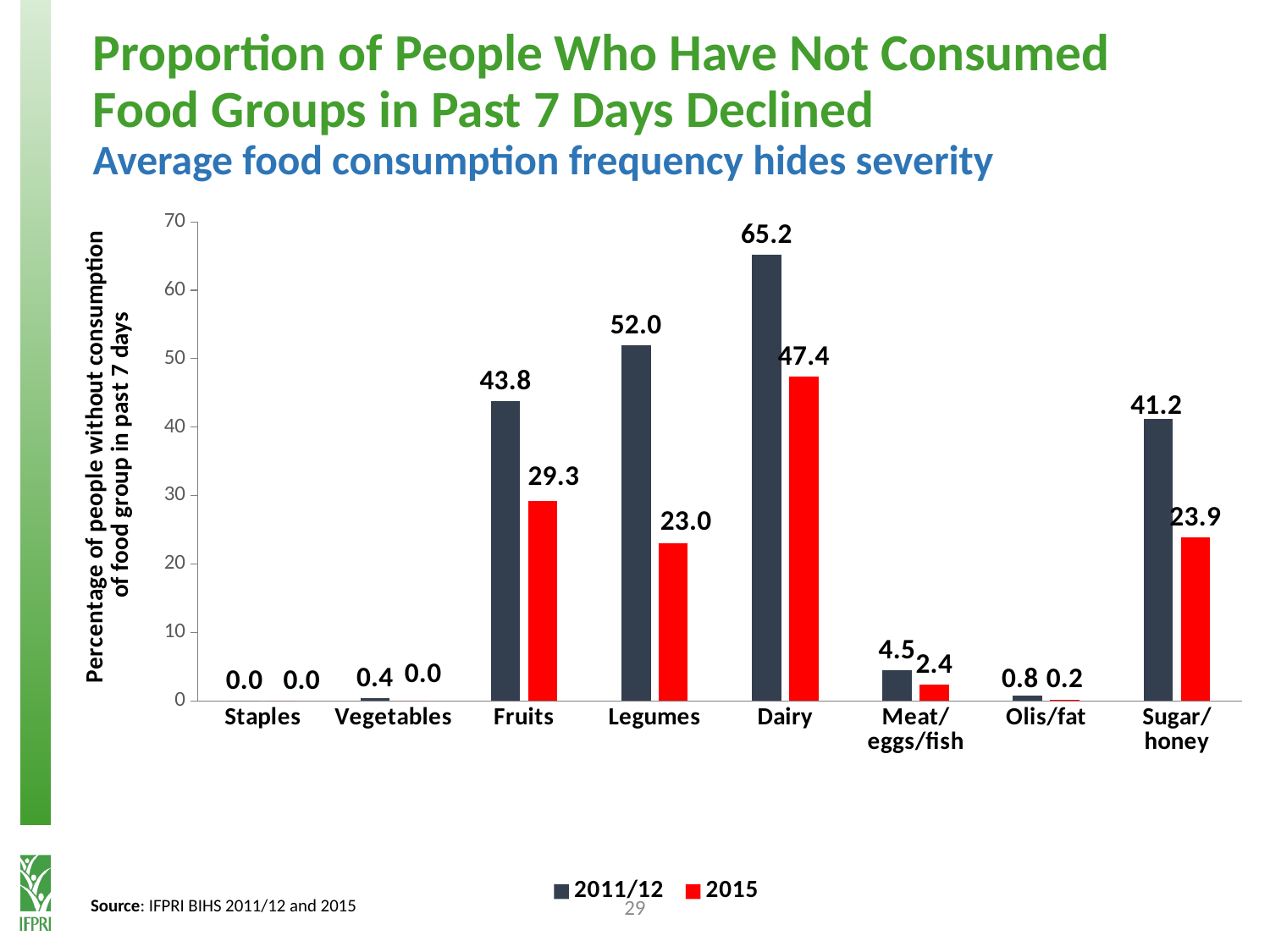
What is the 2015 value for Fruits? 29.3 Which food group has the highest 2011/12 value? Dairy How many series does the legend list? 2 What is the 2011/12 value for Dairy? 65.2 Is the 2011/12 value for Sugar/honey greater or less than 40? greater What is the difference between the 2011/12 and 2015 values for Legumes? 29.0 What is the difference between the 2011/12 and 2015 values for Dairy? 17.8 What is the 2015 value for Sugar/honey? 23.9 Which food group has the lowest 2015 value other than those at 0.0? Olis/fat What kind of chart is shown on the slide? Bar chart How many food groups are shown on the x axis? 8 Which is larger: the 2015 value for Fruits or the 2015 value for Sugar/honey? Fruits